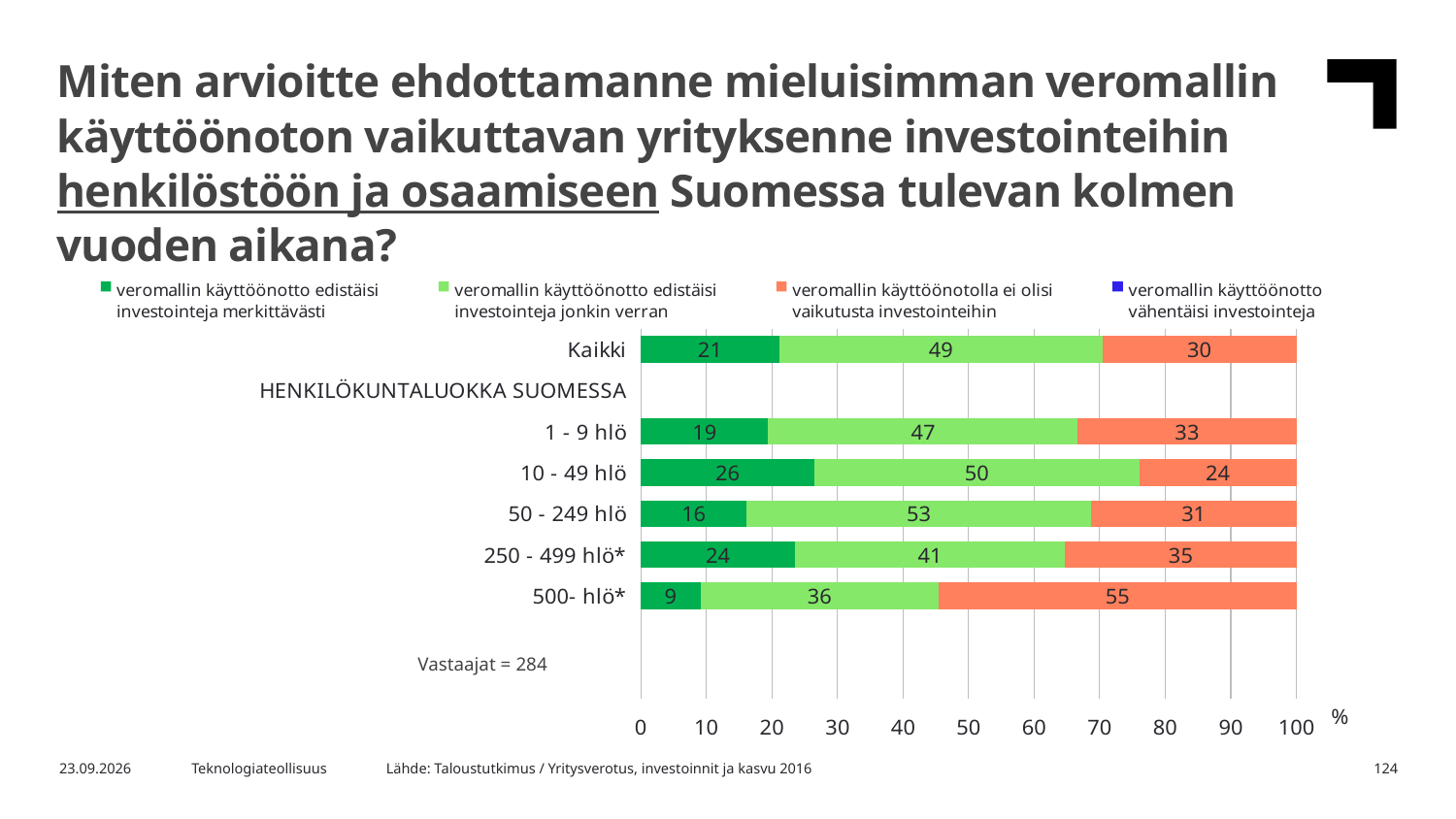
How many respondents (Vastaajat) does the chart report? 284 What is the total of the stacked bar for the 1 - 9 hlö category? 99 How many company size categories (excluding Kaikki) are plotted in the chart? 5 Which company size category has the highest value for 'veromallin käyttöönotto edistäisi investointeja merkittävästi'? 10 - 49 hlö What value is shown for 'veromallin käyttöönotto edistäisi investointeja jonkin verran' in the 50 - 249 hlö category? 53 What is the difference between the 'ei olisi vaikutusta' values for 500- hlö* and 10 - 49 hlö? 31 What percentage of all respondents (Kaikki) said the tax model would significantly promote investments (veromallin käyttöönotto edistäisi investointeja merkittävästi)? 21 What value is shown for 'veromallin käyttöönotolla ei olisi vaikutusta investointeihin' in the 500- hlö* category? 55 How many series does the legend list? 4 What type of chart is shown on the slide? Stacked bar chart Which category has the lowest value for 'veromallin käyttöönotto edistäisi investointeja jonkin verran'? 500- hlö* Which is larger: the 'edistäisi investointeja merkittävästi' value for 250 - 499 hlö* or for 1 - 9 hlö? 250 - 499 hlö*